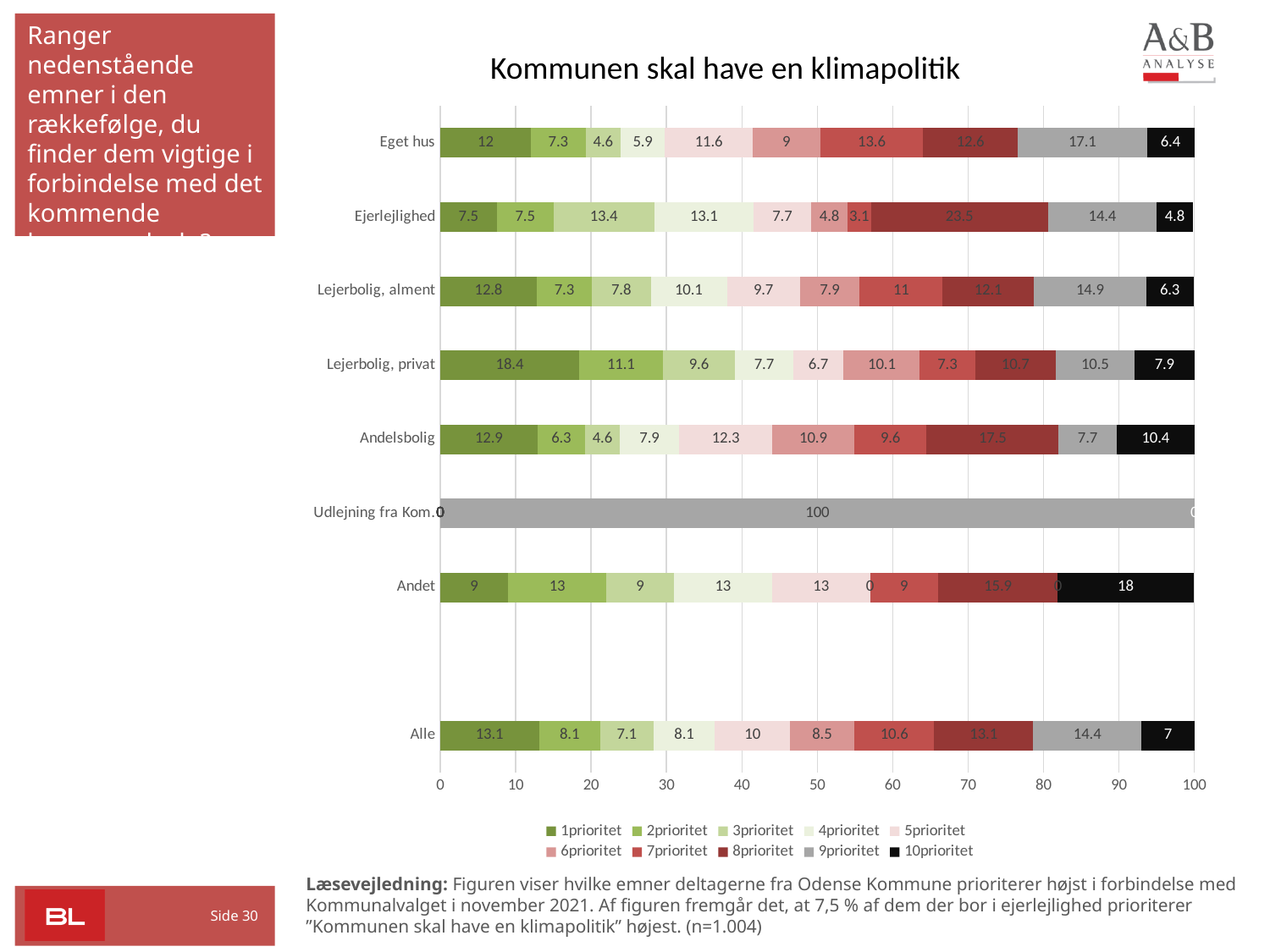
Which category has the highest 1prioritet value? Lejerbolig, privat What is the difference between the 1prioritet values for Lejerbolig, privat and Eget hus? 6.4 What is the 8prioritet value for Ejerlejlighed? 23.5 Which has the larger 9prioritet value, Eget hus or Ejerlejlighed? Eget hus What is the 1prioritet value for Lejerbolig, privat? 18.4 What is the 10prioritet value for Alle? 7 What is the 9prioritet value for Udlejning fra Kom.? 100 What is the title of the chart? Kommunen skal have en klimapolitik Which category has the highest 10prioritet value? Andet What type of chart is shown on the slide? bar chart How many series does the legend list? 10 How many categories are shown on the y axis of the chart? 8